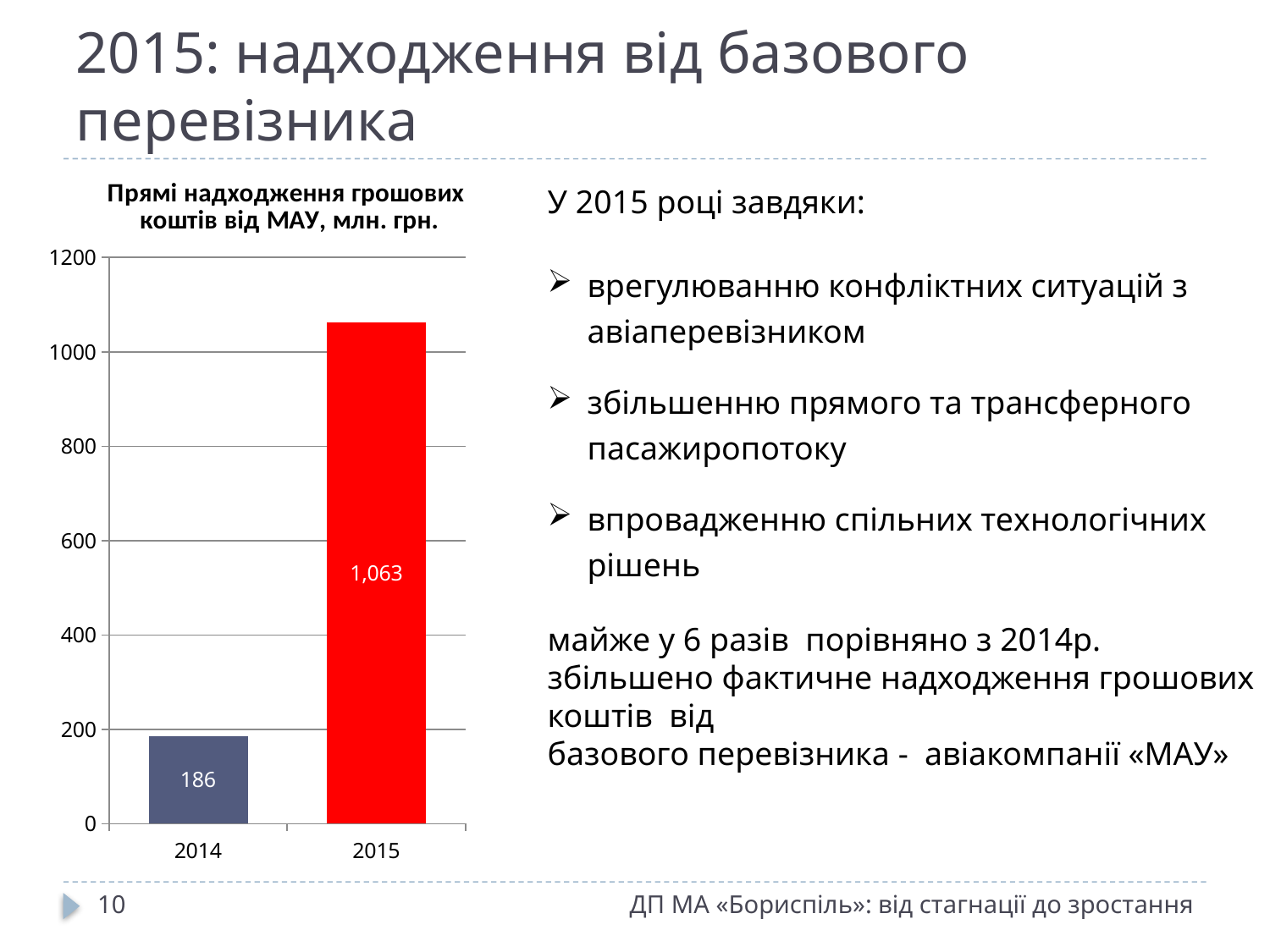
What is the difference between the 2015 and 2014 values? 877 What is the value for 2014? 186 What is the title of the chart? Прямі надходження грошових коштів від МАУ, млн. грн. What colour is the bar for 2015? red Do the values rise or fall from 2014 to 2015? rise How many categories are shown on the x axis? 2 What is the value for 2015? 1,063 Which year has the lower value? 2014 What kind of chart is shown on the slide? bar chart Is the value for 2015 greater or less than 1000? greater Which year has the higher value? 2015 Is the value for 2014 greater or less than 200? less